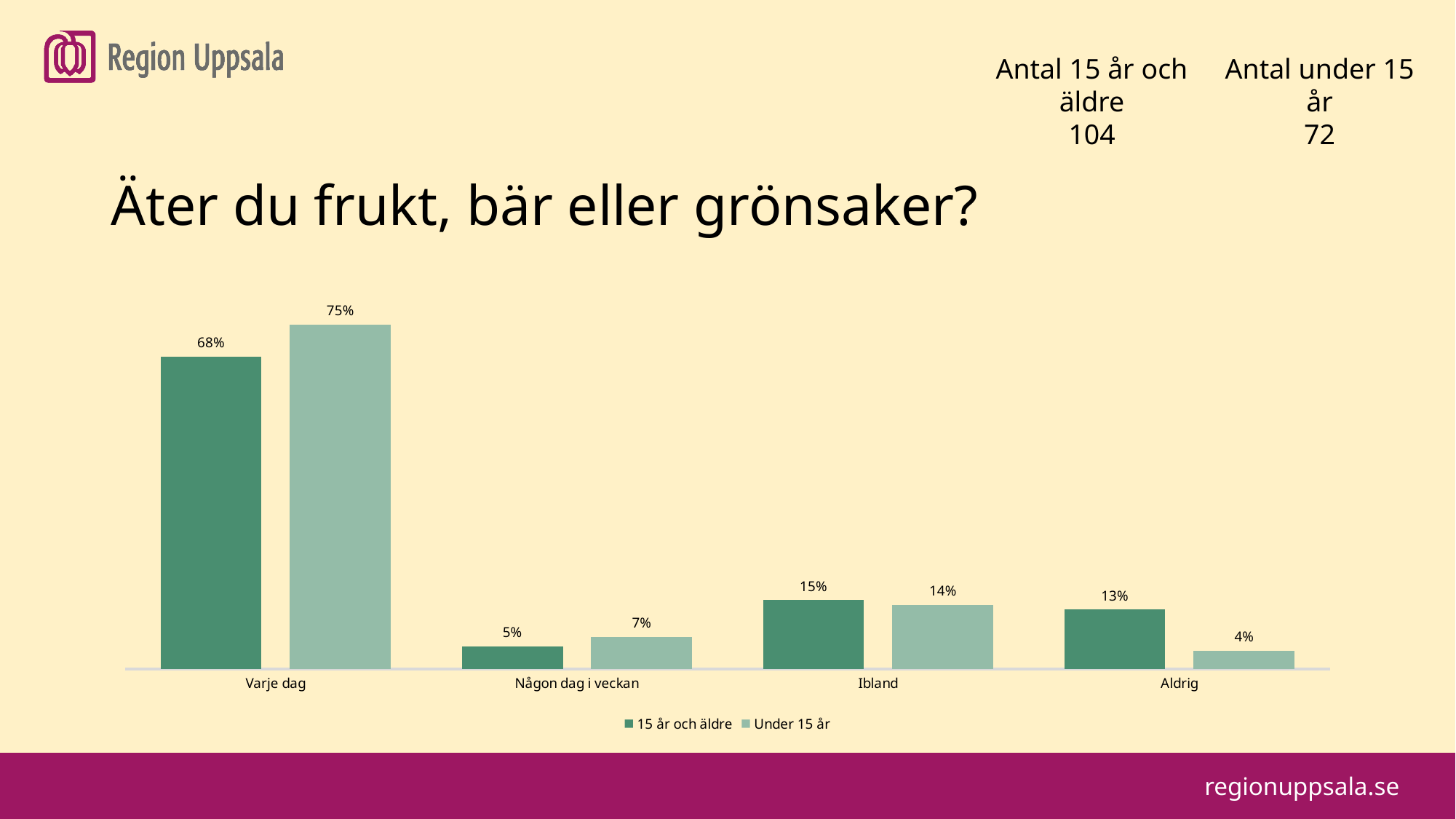
Which category has the highest value for "Under 15 år"? Varje dag What is the value for "Under 15 år" in the "Aldrig" category? 4% What is the difference between the "Under 15 år" and "15 år och äldre" values in the "Varje dag" category? 7% What is the difference between the "15 år och äldre" and "Under 15 år" values in the "Aldrig" category? 9% How many series does the legend list? 2 Which category has the lowest value for "15 år och äldre"? Någon dag i veckan What kind of chart is shown on the slide? Bar chart Which is larger in the "Ibland" category: "15 år och äldre" or "Under 15 år"? 15 år och äldre How many categories are shown on the x axis? 4 What is the value for "15 år och äldre" in the "Varje dag" category? 68% What is the title of the chart? Äter du frukt, bär eller grönsaker? What is the value for "Under 15 år" in the "Någon dag i veckan" category? 7%